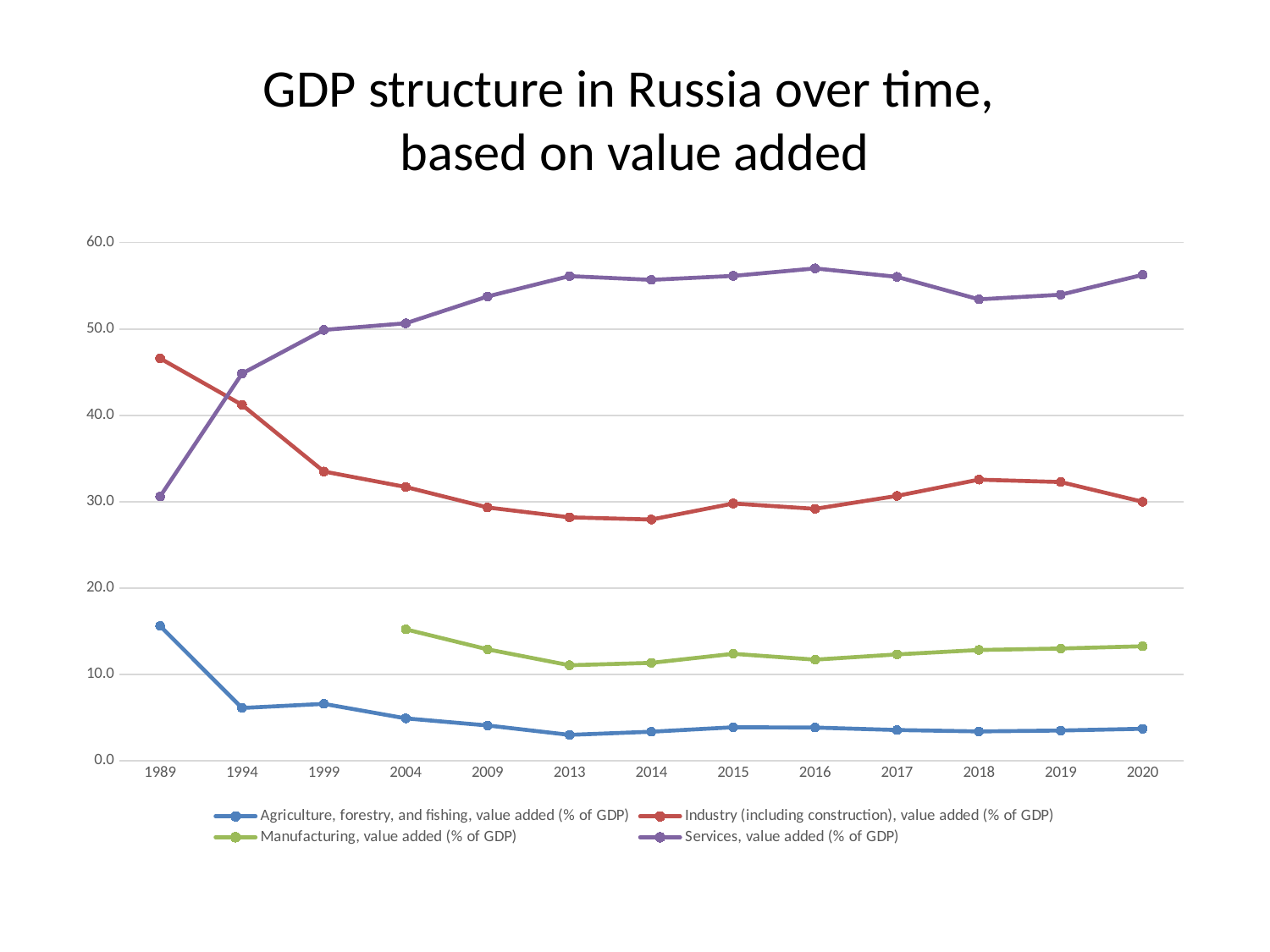
In 1989, which is larger: Industry (including construction) or Services, value added (% of GDP)? Industry (including construction) Is the value for Services, value added (% of GDP) in 2016 greater or less than 50.0? greater In which year is Manufacturing, value added (% of GDP) lowest? 2013 How many years are plotted along the x axis? 13 Is the value for Industry (including construction), value added (% of GDP) in 1989 greater or less than 40.0? greater What kind of chart is shown on the slide? Line chart Is the value for Industry (including construction), value added (% of GDP) in 2014 greater or less than 30.0? less How many series does the legend list? 4 What is the title of the chart? GDP structure in Russia over time, based on value added Does the Agriculture, forestry, and fishing series rise or fall overall from 1989 to 2020? Fall In which year is Industry (including construction), value added (% of GDP) highest? 1989